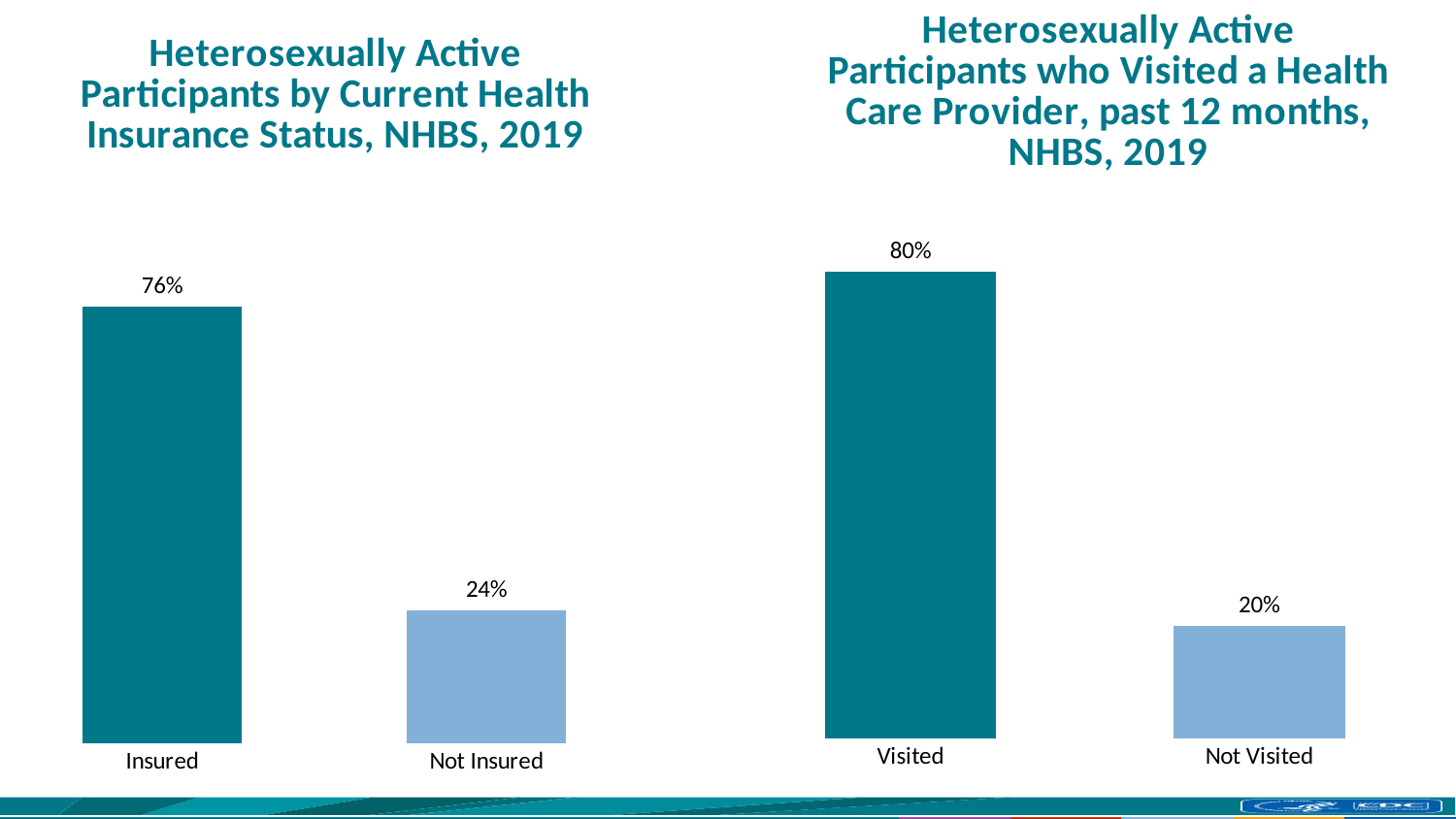
In the left chart (Heterosexually Active Participants by Current Health Insurance Status), what is the value for Insured? 76% In the right chart (Heterosexually Active Participants who Visited a Health Care Provider), what is the value for Not Visited? 20% In the left chart (Heterosexually Active Participants by Current Health Insurance Status), what is the value for Not Insured? 24% In the left chart (Heterosexually Active Participants by Current Health Insurance Status), which category has the highest value? Insured Which is larger: the Insured value in the left chart or the Visited value in the right chart? Visited What kind of chart is the right chart (Heterosexually Active Participants who Visited a Health Care Provider)? Bar chart What is the title of the left chart? Heterosexually Active Participants by Current Health Insurance Status, NHBS, 2019 In the right chart (Heterosexually Active Participants who Visited a Health Care Provider), what is the difference between the Visited and Not Visited values? 60% How many categories are shown in the left chart (Heterosexually Active Participants by Current Health Insurance Status)? 2 In the left chart (Heterosexually Active Participants by Current Health Insurance Status), what is the difference between the Insured and Not Insured values? 52% In the right chart (Heterosexually Active Participants who Visited a Health Care Provider), which category has the lowest value? Not Visited In the right chart (Heterosexually Active Participants who Visited a Health Care Provider), what is the value for Visited? 80%